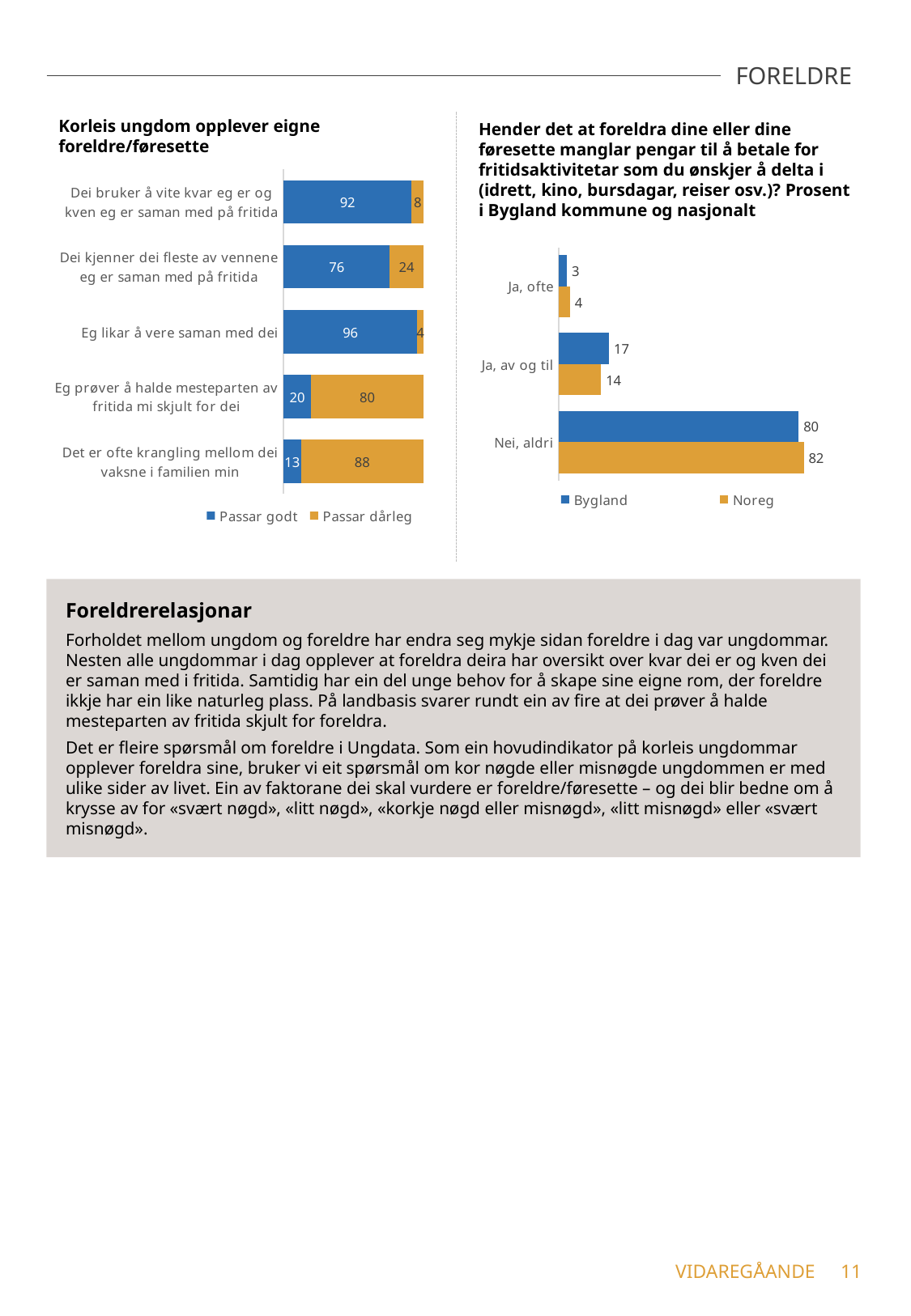
In the left chart (Korleis ungdom opplever eigne foreldre/føresette), which statement has the lowest 'Passar godt' value? Det er ofte krangling mellom dei vaksne i familien min In the right chart (Hender det at foreldra dine eller dine føresette manglar pengar...), what is the Noreg value for 'Nei, aldri'? 82 In the left chart (Korleis ungdom opplever eigne foreldre/føresette), how many series does the legend list? 2 In the left chart (Korleis ungdom opplever eigne foreldre/føresette), which statement has the highest 'Passar godt' value? Eg likar å vere saman med dei In the left chart (Korleis ungdom opplever eigne foreldre/føresette), what is the 'Passar godt' value for 'Eg likar å vere saman med dei'? 96 In the left chart (Korleis ungdom opplever eigne foreldre/føresette), how many statements are shown? 5 In the right chart (Hender det at foreldra dine eller dine føresette manglar pengar...), which is larger for 'Ja, av og til': Bygland or Noreg? Bygland In the right chart (Hender det at foreldra dine eller dine føresette manglar pengar...), what is the Bygland value for 'Ja, av og til'? 17 What kind of chart is the left chart (Korleis ungdom opplever eigne foreldre/føresette)? Stacked bar chart In the left chart (Korleis ungdom opplever eigne foreldre/føresette), what is the difference between the 'Passar dårleg' values for 'Eg prøver å halde mesteparten av fritida mi skjult for dei' and 'Dei kjenner dei fleste av vennene eg er saman med på fritida'? 56 In the right chart (Hender det at foreldra dine eller dine føresette manglar pengar...), what is the difference between the Noreg and Bygland values for 'Nei, aldri'? 2 In the left chart (Korleis ungdom opplever eigne foreldre/føresette), what is the 'Passar dårleg' value for 'Det er ofte krangling mellom dei vaksne i familien min'? 88